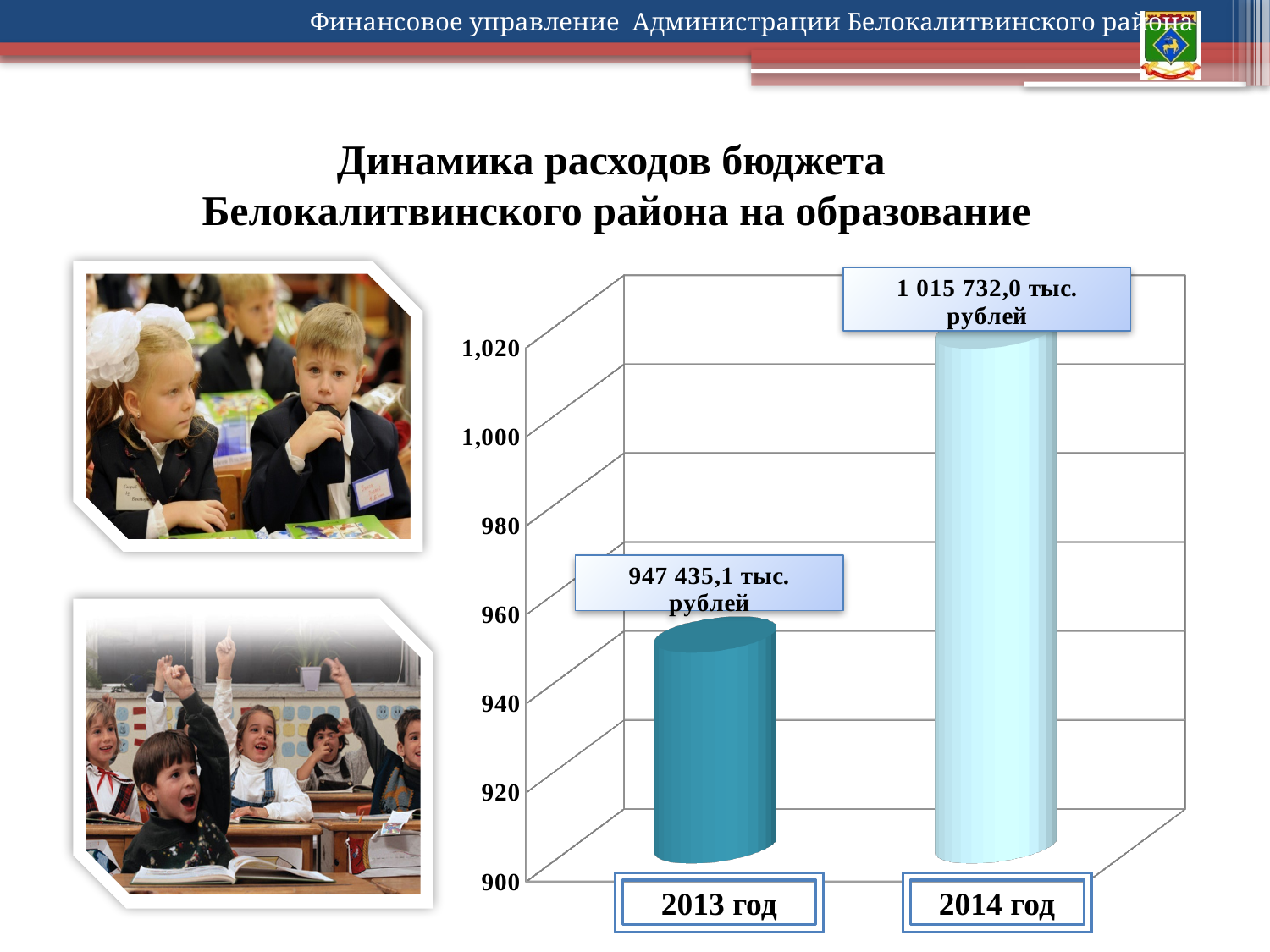
Do the values rise or fall from 2013 год to 2014 год? rise What is the title of the chart on the slide? Динамика расходов бюджета Белокалитвинского района на образование Which year has the higher education expenditure? 2014 год Is the value for 2013 год larger or smaller than the value for 2014 год? smaller What type of chart is used on the slide? bar chart Which year has the lower education expenditure? 2013 год Is the value for 2014 год greater or less than 1,000 on the axis? greater Is the value for 2013 год greater or less than 960 on the axis? less How many years (categories) are shown in the chart? 2 By how much did the expenditure in 2014 год exceed that of 2013 год? 68 296,9 тыс. рублей What is the value shown for 2014 год? 1 015 732,0 тыс. рублей What is the value shown for 2013 год? 947 435,1 тыс. рублей